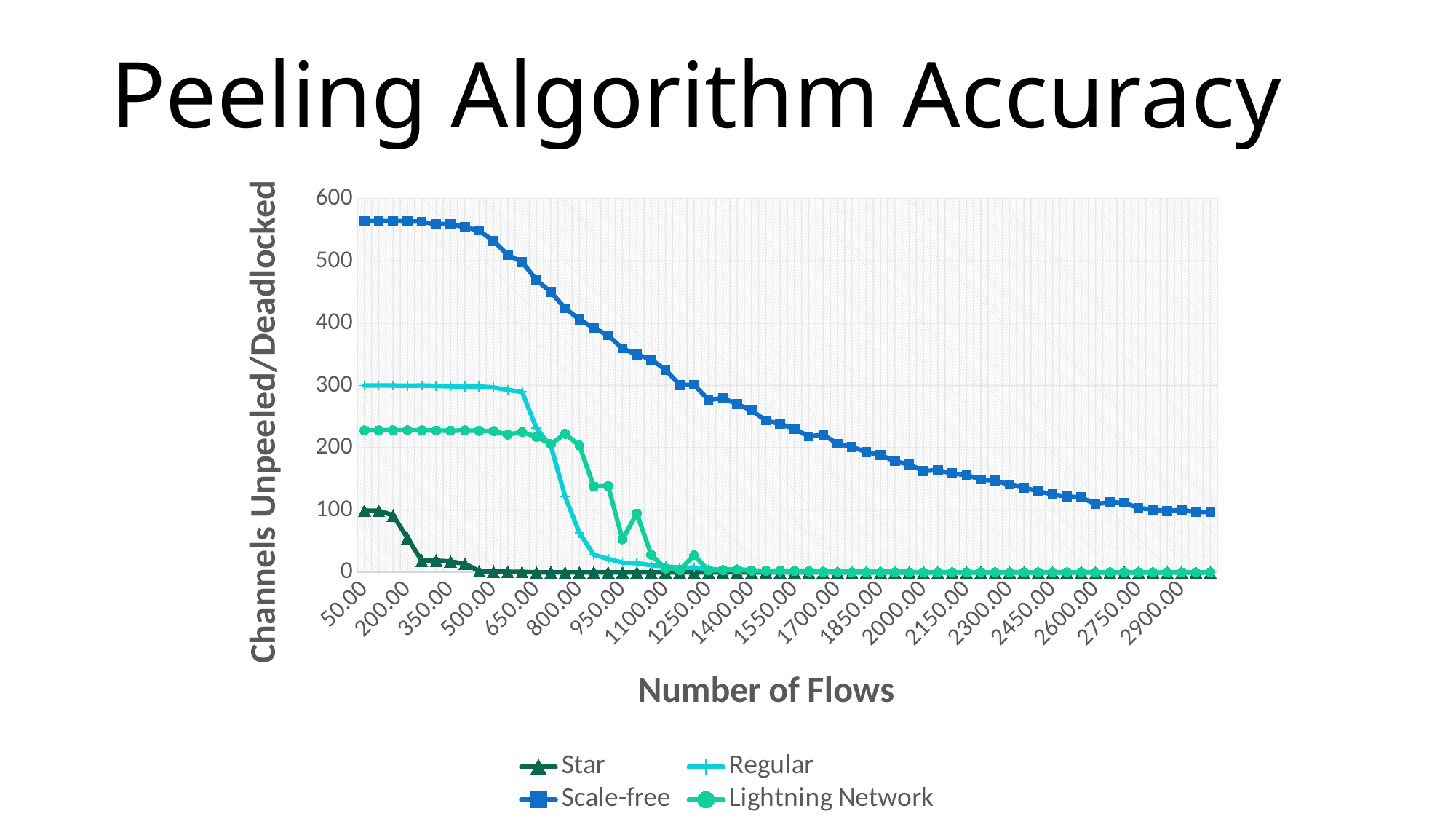
How many series does the legend list? 4 What is the title of the chart on the slide? Peeling Algorithm Accuracy Which series has the lowest value at 50.00 flows? Star Is the value for Scale-free at 650.00 flows greater or less than 400? greater At 50.00 flows, which is larger: the value for Regular or the value for Lightning Network? Regular What is the label of the x axis? Number of Flows Does the Scale-free series rise or fall as the number of flows increases? fall What kind of chart is shown on the slide? line chart Which series has the highest value at 50.00 flows? Scale-free Is the value for Scale-free at 50.00 flows greater or less than 500? greater Is the value for Lightning Network at 50.00 flows greater or less than 200? greater